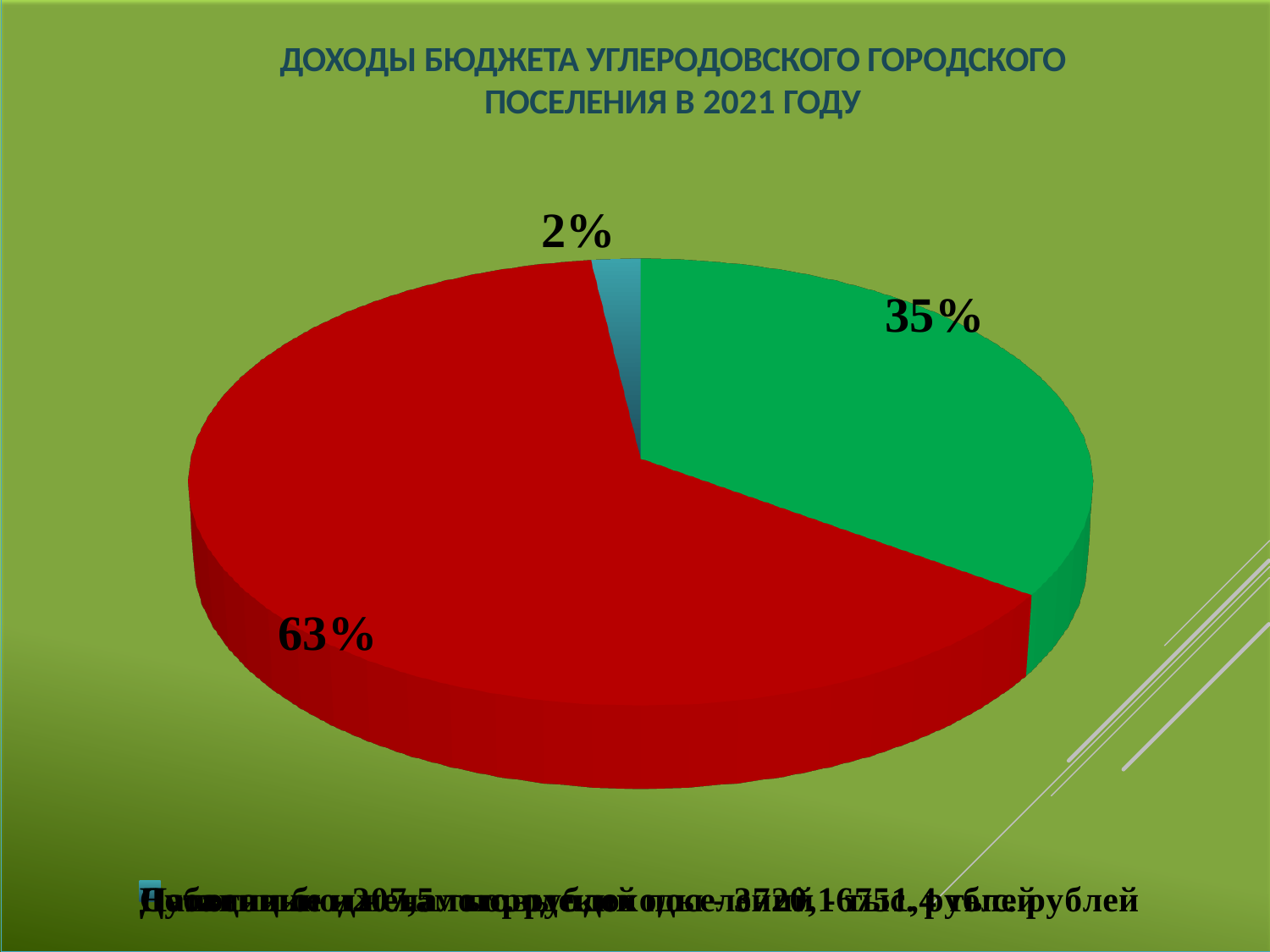
Is the share of the red slice greater or less than 50%? greater Which slice of the pie chart is the smallest? The blue slice (2%) What kind of chart is shown on the slide? Pie chart What is the combined share of the green and blue slices? 37% What percentage is shown for the red slice of the pie chart? 63% What is the title of the chart on the slide? ДОХОДЫ БЮДЖЕТА УГЛЕРОДОВСКОГО ГОРОДСКОГО ПОСЕЛЕНИЯ В 2021 ГОДУ What percentage is shown for the small blue slice of the pie chart? 2% Which is larger, the green slice or the blue slice? The green slice What percentage is shown for the green slice of the pie chart? 35% How many slices does the pie chart have? 3 Which slice of the pie chart is the largest? The red slice (63%) What is the difference in percentage points between the red slice and the green slice? 28